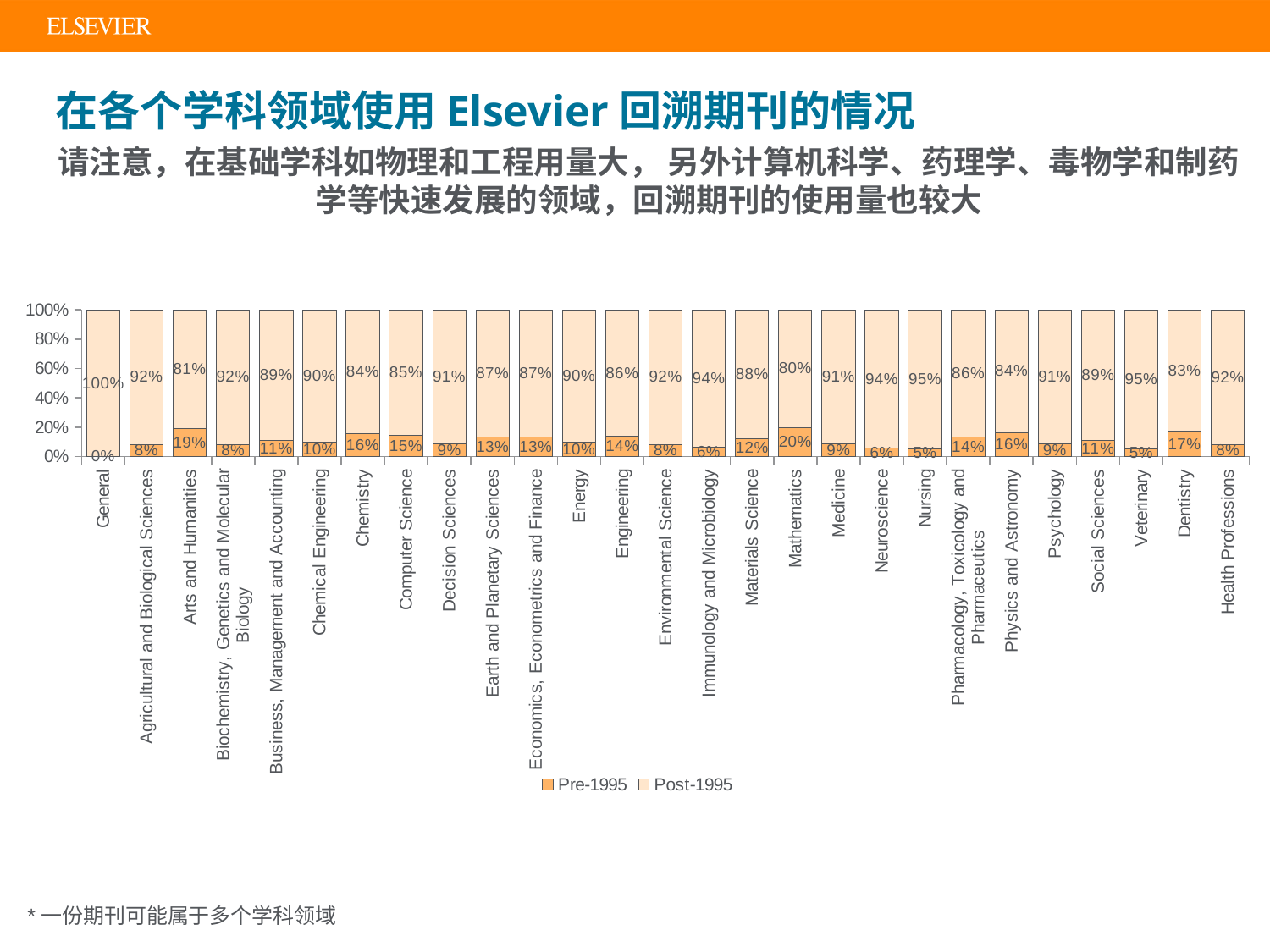
How many categories are shown on the x axis? 27 What is the Pre-1995 value for Computer Science? 15% Which category has the lowest Pre-1995 value? General What is the difference between the Pre-1995 values for Dentistry and Veterinary? 12% What is the Post-1995 value for Nursing? 95% Which category has the highest Pre-1995 value? Mathematics What kind of chart is shown on the slide? Stacked bar chart What is the Post-1995 value for Arts and Humanities? 81% How many series does the legend list? 2 What is the Pre-1995 value for Mathematics? 20% Which category has the lowest Post-1995 value? Mathematics Which has a larger Pre-1995 value, Chemistry or Engineering? Chemistry